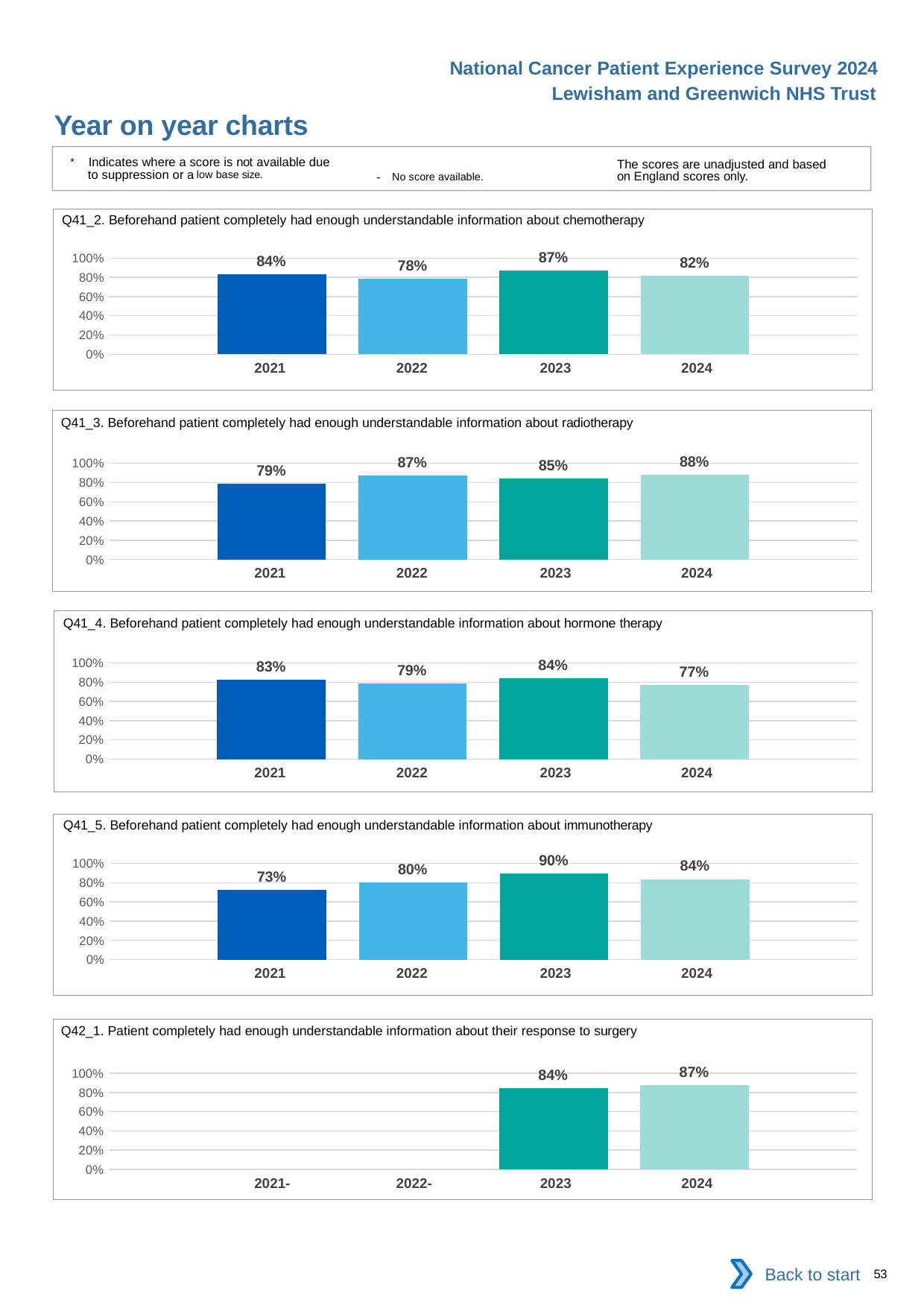
In the Q41_4 hormone therapy chart, which year has the lowest value? 2024 In the Q41_2 chemotherapy chart, is the value for 2022 larger or smaller than the value for 2021? smaller How many years have bars plotted in the Q42_1 surgery chart? 2 In the Q41_4 hormone therapy chart, what is the difference between the 2023 and 2024 values? 7% What type of chart is the Q41_5 immunotherapy chart? bar chart In the Q41_5 immunotherapy chart, is the value for 2021 greater or less than 80%? less In the Q41_3 radiotherapy chart, what is the value for 2021? 79% In the Q42_1 surgery chart, what is the value for 2024? 87% In the Q41_5 immunotherapy chart, what is the difference between the 2023 and 2021 values? 17% In the Q41_3 radiotherapy chart, which year has the highest value? 2024 How many charts are shown on the slide? 5 In the Q41_2 chemotherapy chart, what is the value for 2023? 87%